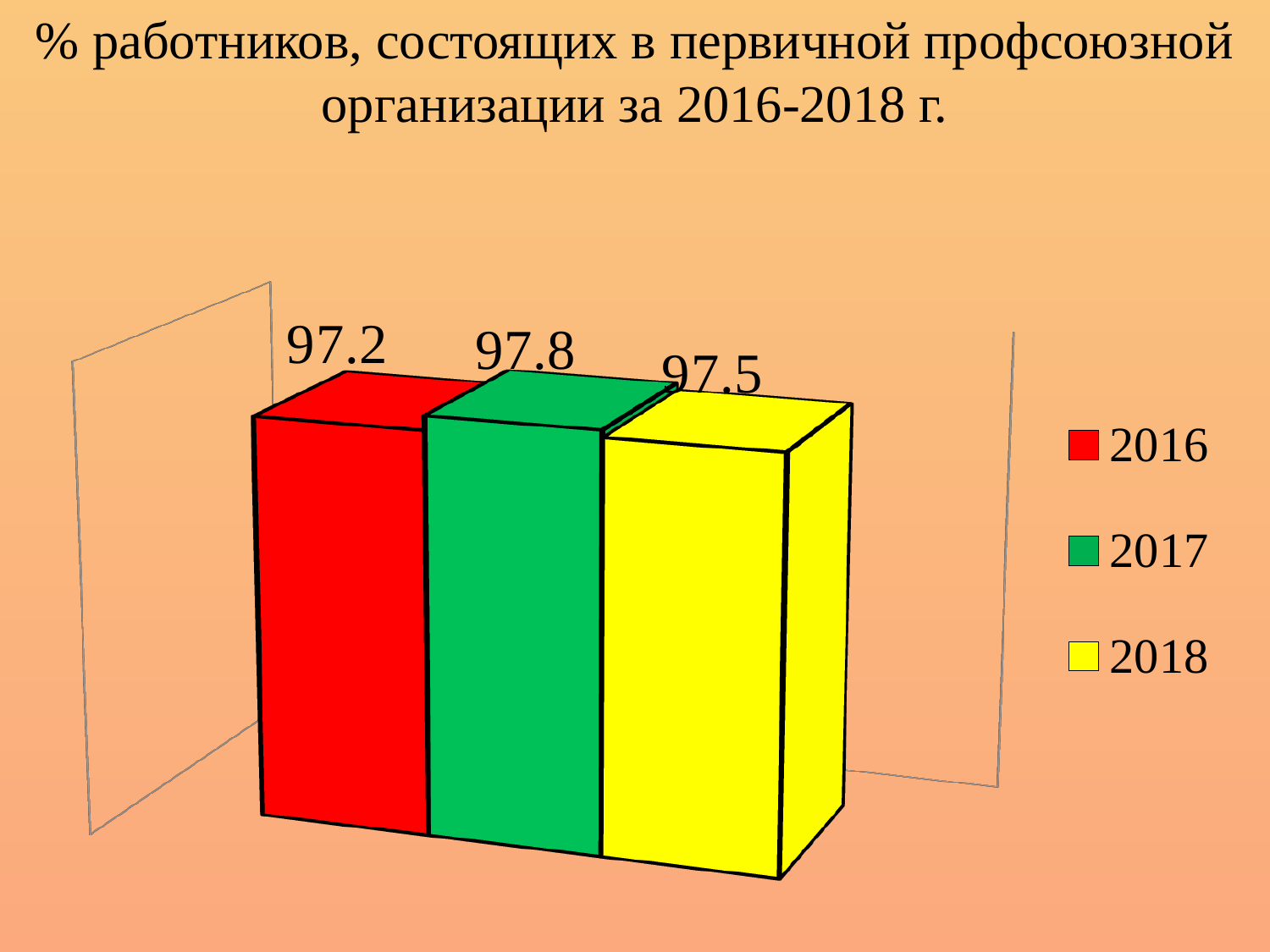
What is the difference between the values for 2017 and 2016? 0.6 Which year has the highest value? 2017 What is the value for 2018? 97.5 Which is larger, the value for 2018 or the value for 2016? 2018 What kind of chart is shown on the slide? bar chart How many bars are shown in the chart? 3 What is the value for 2016? 97.2 What is the difference between the values for 2017 and 2018? 0.3 What is the value for 2017? 97.8 Which year has the lowest value? 2016 How many entries does the legend list? 3 Does the value rise or fall from 2017 to 2018? fall